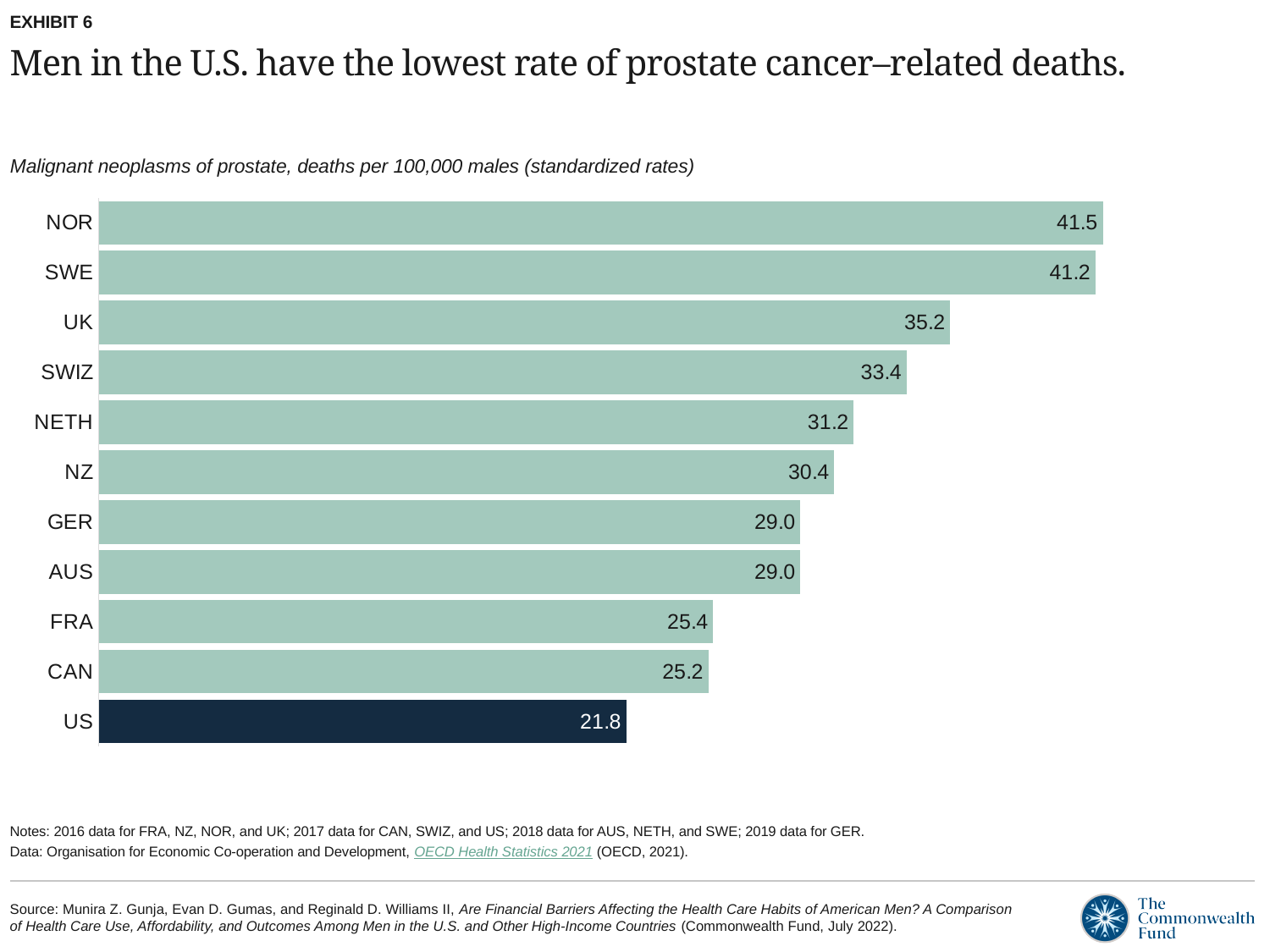
What is the prostate cancer death rate per 100,000 males for the UK? 35.2 What is the difference between the values for SWIZ and NZ? 3.0 What is the value shown for the US? 21.8 Which has a higher value, FRA or NETH? NETH What is the value shown for NETH? 31.2 What type of chart is shown on the slide? Bar chart Which two countries share the same value of 29.0? GER and AUS Which bar is shown in a different (dark navy) colour from the others? US How many countries are shown in the chart? 11 Which country has the highest prostate cancer death rate? NOR Which country has the lowest prostate cancer death rate? US What is the difference between the values for NOR and the US? 19.7